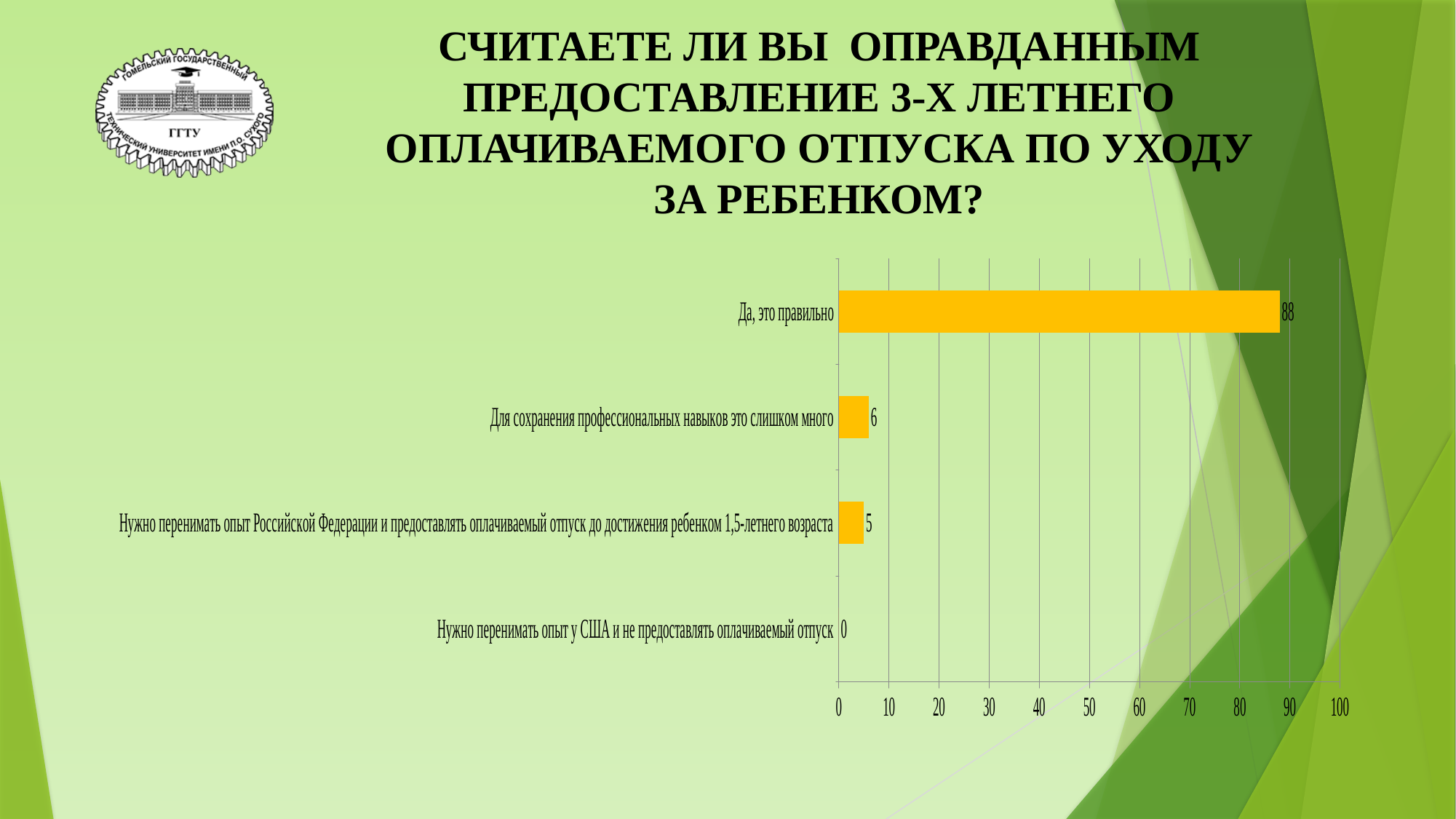
Which category has the lowest value? Нужно перенимать опыт у США и не предоставлять оплачиваемый отпуск What is the difference between the value for "Да, это правильно" and the value for "Для сохранения профессиональных навыков это слишком много"? 82 How many categories are shown in the chart? 4 Which category has the highest value? Да, это правильно What is the value for "Для сохранения профессиональных навыков это слишком много"? 6 What is the value for "Нужно перенимать опыт у США и не предоставлять оплачиваемый отпуск"? 0 Which is larger: the value for "Для сохранения профессиональных навыков это слишком много" or the value for "Нужно перенимать опыт Российской Федерации и предоставлять оплачиваемый отпуск до достижения ребенком 1,5-летнего возраста"? Для сохранения профессиональных навыков это слишком много What is the value for "Нужно перенимать опыт Российской Федерации и предоставлять оплачиваемый отпуск до достижения ребенком 1,5-летнего возраста"? 5 What kind of chart is shown on the slide? bar chart What is the maximum value shown on the horizontal axis? 100 Is the value for "Да, это правильно" greater or less than 80? greater What is the value for "Да, это правильно"? 88